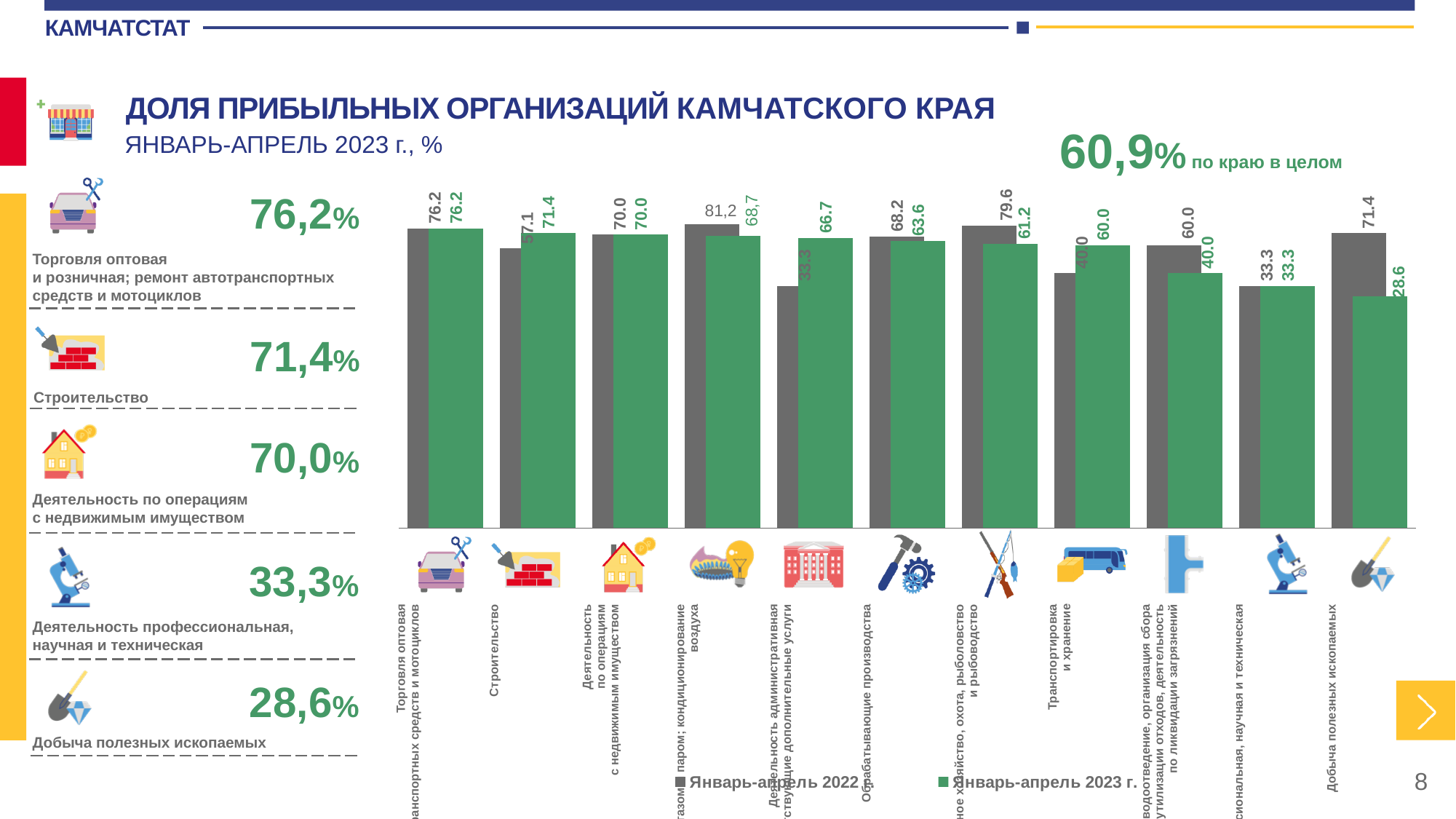
Which category has the lowest value in the Январь-апрель 2023 г. series? Добыча полезных ископаемых What type of chart is shown on the slide? bar chart How many categories (industries) are plotted on the chart? 11 For Добыча полезных ископаемых, which series has the larger value: Январь-апрель 2022 or Январь-апрель 2023 г.? Январь-апрель 2022 What is the value for Транспортировка и хранение in the Январь-апрель 2022 series? 40.0 Do the Январь-апрель 2023 г. values rise or fall from left to right along the x axis? fall What share of profitable organisations is given for the region as a whole (по краю в целом)? 60,9% How many series does the chart legend list? 2 What is the highest value in the Январь-апрель 2022 series? 81,2 What is the value for Обрабатывающие производства in the Январь-апрель 2022 series? 68.2 What is the difference between the 2023 and 2022 values for Строительство? 14.3 What is the value for Строительство in the Январь-апрель 2023 г. series? 71.4